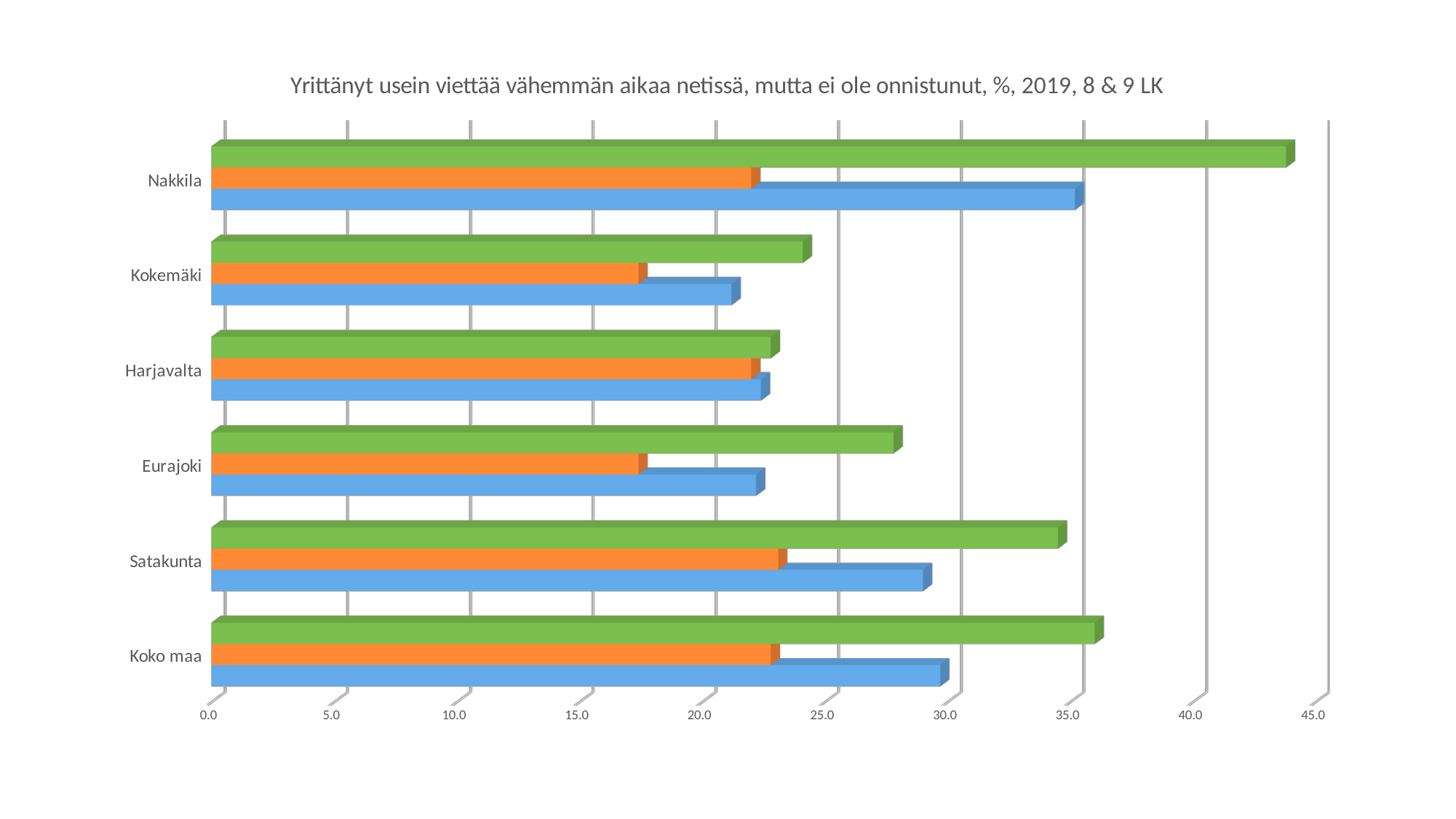
How many bars are plotted for each category? 3 Is the orange bar for Eurajoki greater or less than 20.0? less Is the blue bar for Satakunta greater or less than 30.0? less Is the green bar for Koko maa greater or less than 35.0? greater How many categories (areas) are shown on the vertical axis? 6 What kind of chart is shown on the slide? bar chart What is the title of the chart? Yrittänyt usein viettää vähemmän aikaa netissä, mutta ei ole onnistunut, %, 2019, 8 & 9 LK Which is larger, the blue bar for Nakkila or the blue bar for Kokemäki? Nakkila Which category has the longest green bar? Nakkila